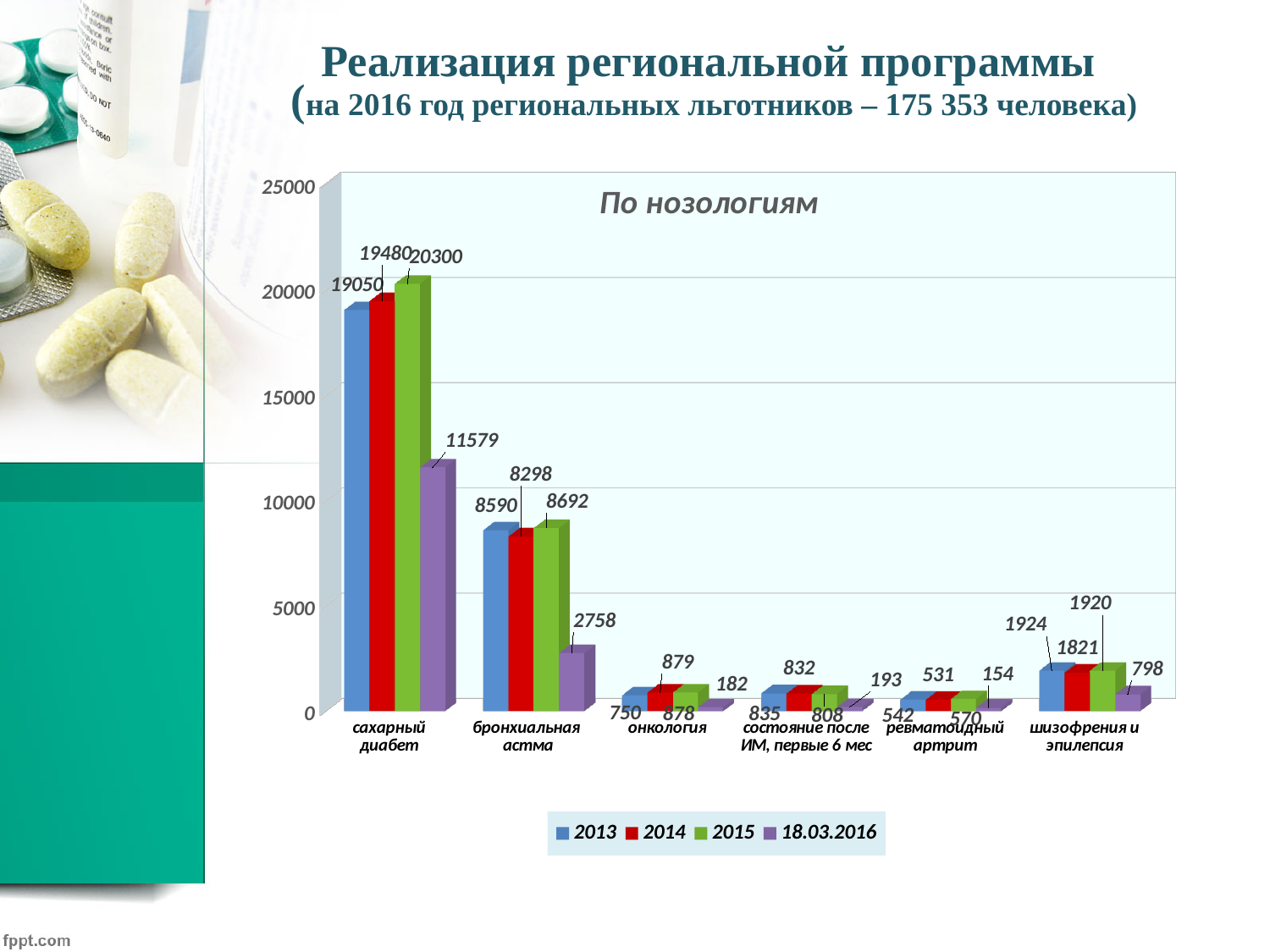
What is the value for сахарный диабет in the 2015 series? 20300 What is the difference between the 2015 and 2013 values for сахарный диабет? 1250 What is the title of the chart? По нозологиям What is the value for шизофрения и эпилепсия in the 2013 series? 1924 How many series does the legend list? 4 Which category has the highest value in the 2014 series? сахарный диабет Which is larger for онкология: the 2013 value or the 2014 value? 2014 What kind of chart is shown on the slide? bar chart How many categories are shown on the x axis? 6 What is the value for ревматоидный артрит in the 2015 series? 570 Which category has the lowest value in the 18.03.2016 series? ревматоидный артрит What is the value for бронхиальная астма in the 18.03.2016 series? 2758